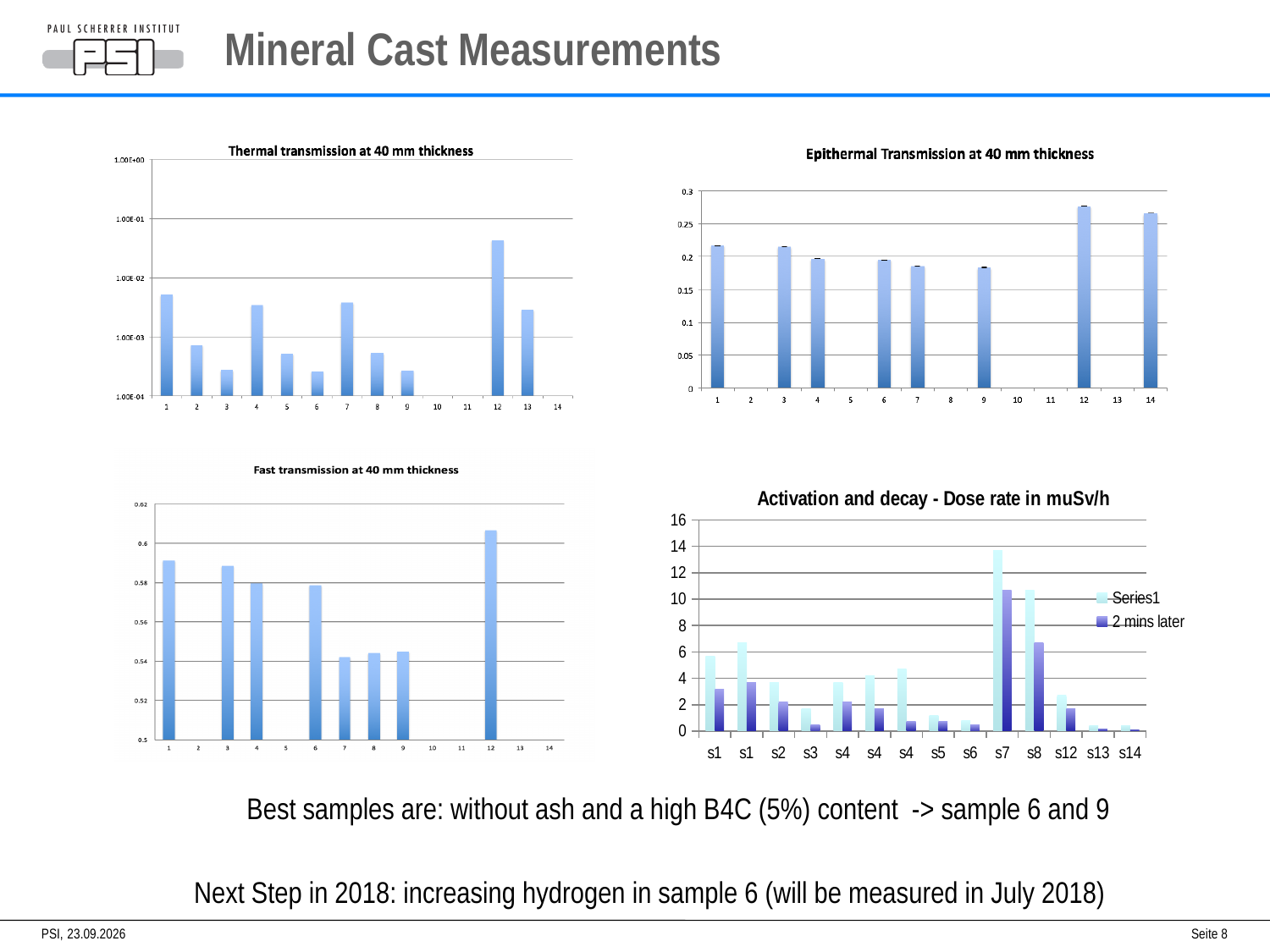
In the 'Fast transmission at 40 mm thickness' chart, which is larger, the value for sample 1 or the value for sample 4? sample 1 In the 'Epithermal Transmission at 40 mm thickness' chart, how many bars are plotted? 8 How many series does the legend of the 'Activation and decay - Dose rate in muSv/h' chart list? 2 In the 'Fast transmission at 40 mm thickness' chart, which sample number has the highest value? 12 What type of chart is the 'Thermal transmission at 40 mm thickness' chart? bar chart In the 'Activation and decay - Dose rate in muSv/h' chart, is the Series1 value for s7 greater or less than 12? greater In the 'Fast transmission at 40 mm thickness' chart, is the value for sample 7 greater or less than 0.56? less In the 'Thermal transmission at 40 mm thickness' chart, which sample number has the highest value? 12 In the 'Epithermal Transmission at 40 mm thickness' chart, is the value for sample 9 greater or less than 0.2? less In the 'Epithermal Transmission at 40 mm thickness' chart, which sample number has the highest value? 12